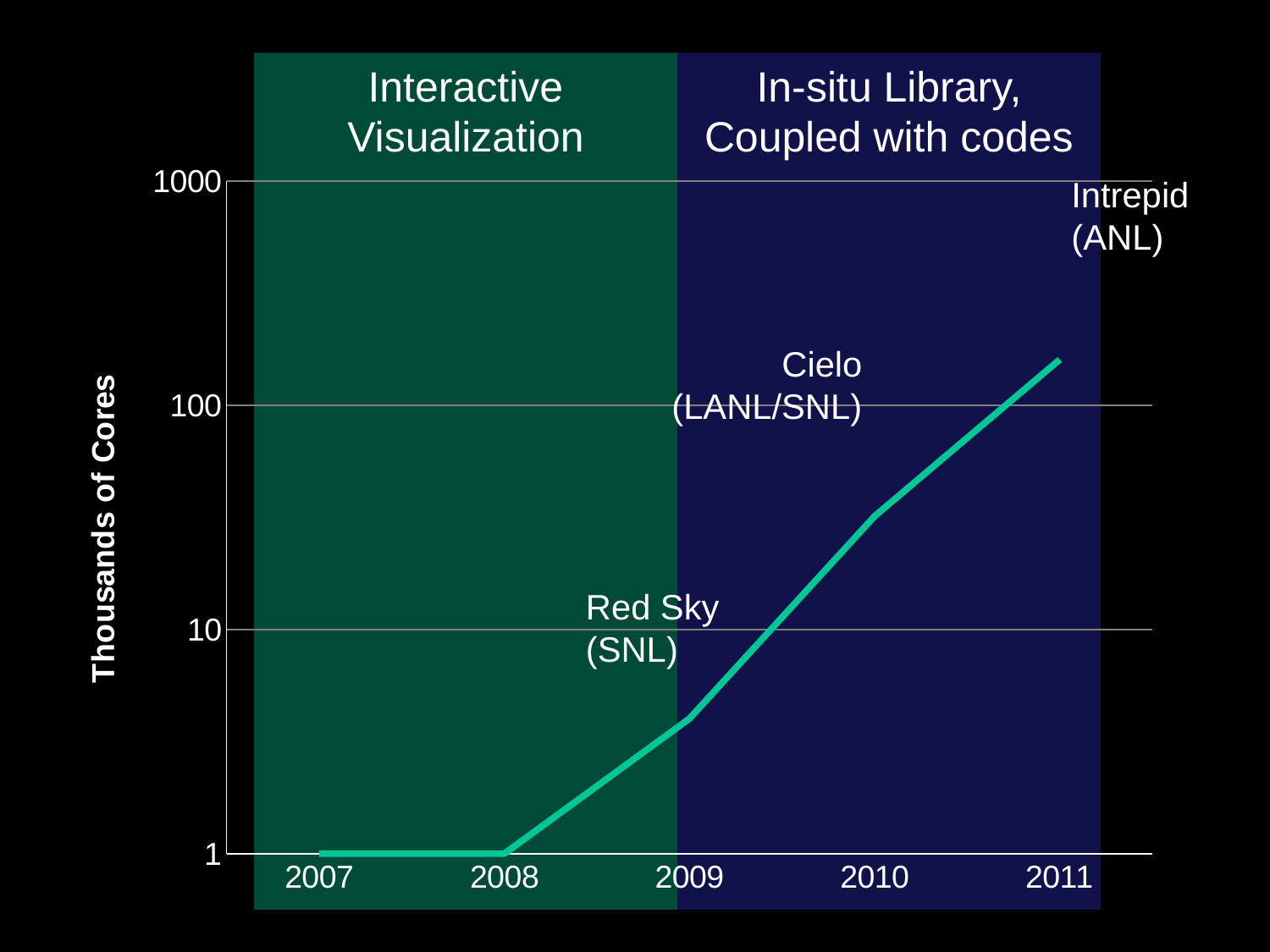
What is the value for 2007? 1 How many years are marked on the x axis? 5 What label is shown in the green shaded region on the left of the chart? Interactive Visualization Is the value for 2010 greater or less than 10? greater Is the value for 2011 greater or less than 100? greater Do the values rise or fall from 2008 to 2011? rise What is the label of the y axis? Thousands of Cores Is the value for 2009 greater or less than 10? less What kind of chart is shown on the slide? line chart Which year has the highest value on the line? 2011 Which is larger, the value for 2009 or the value for 2010? 2010